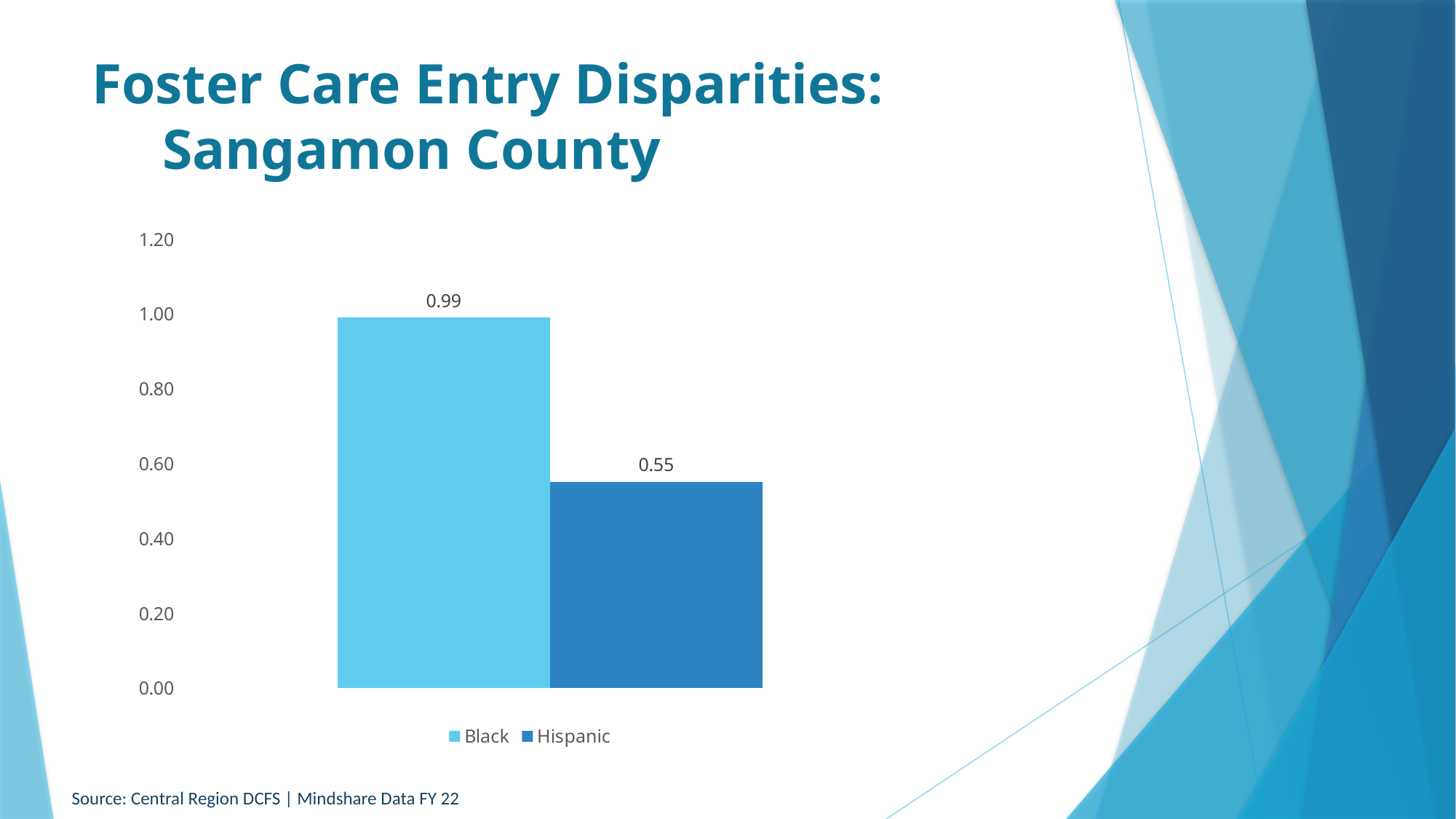
How many series does the legend list? 2 Is the value for Black greater or less than 0.80? greater What is the difference between the values for Black and Hispanic? 0.44 How many bars are plotted on the chart? 2 Which is larger, the value for Black or the value for Hispanic? Black What is the value for Black? 0.99 Is the value for Hispanic greater or less than 0.60? less Which series has the lowest value? Hispanic What is the title of the slide? Foster Care Entry Disparities: Sangamon County Which series has the highest value? Black What is the value for Hispanic? 0.55 What kind of chart is shown on the slide? bar chart